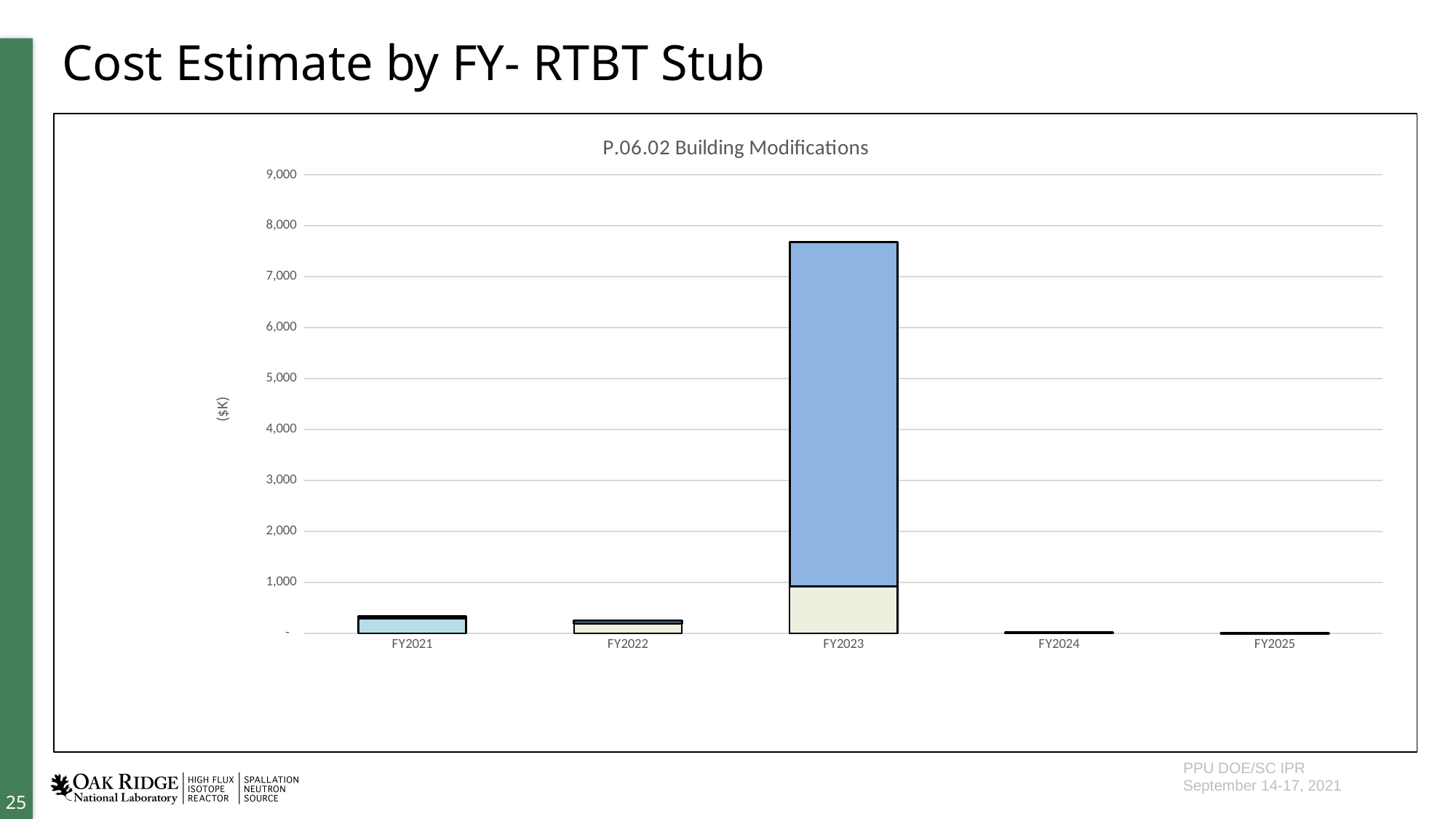
Which fiscal year has the highest total cost estimate in the chart? FY2023 What is the label on the vertical axis of the chart? ($K) Is the value for FY2022 greater or less than 1,000? less Is the total value for FY2023 greater or less than 7,000? greater What kind of chart is shown on the slide? bar chart What is the title of the chart? P.06.02 Building Modifications What is the highest value shown on the vertical axis of the chart? 9,000 Which is larger, the total value for FY2021 or the total value for FY2022? FY2021 How many fiscal years are shown on the x axis of the chart? 5 Is the total value for FY2023 greater or less than 8,000? less Which is larger, the total value for FY2023 or the total value for FY2021? FY2023